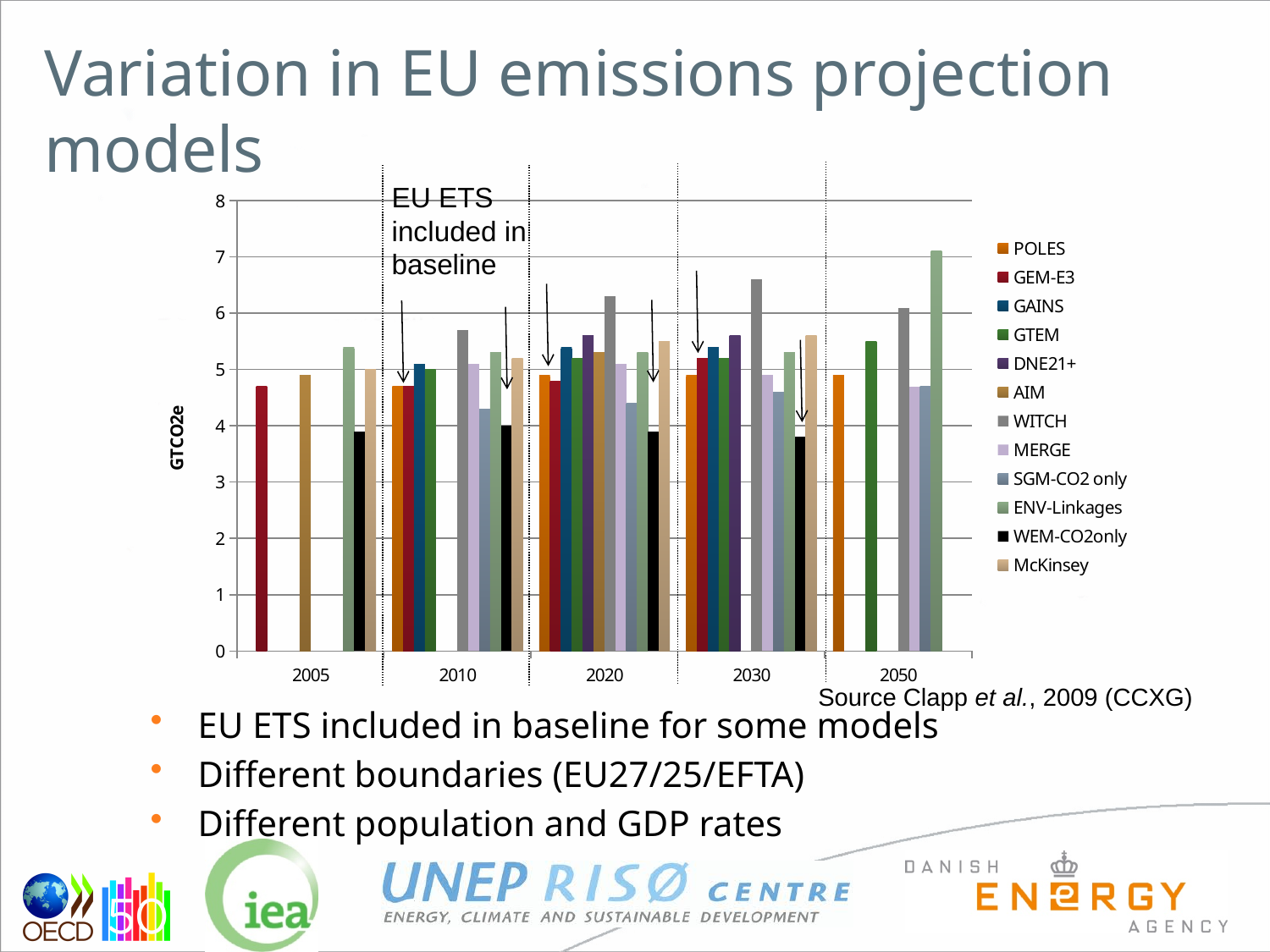
What kind of chart is shown on the slide? bar chart Which model has the highest projected value in 2030? WITCH In 2020, which is larger: the value for WITCH or the value for POLES? WITCH Is the value for GEM-E3 in 2005 greater or less than 5? less Is the value for WEM-CO2only in 2010 greater or less than 5? less What is the label on the y axis? GTCO2e How many series does the legend list? 12 Which model has the highest projected value in 2050? ENV-Linkages Is the value for ENV-Linkages in 2050 greater or less than 6? greater How many year categories are shown on the x axis? 5 Does the value for WITCH rise or fall from 2010 to 2030? rise Which model has the lowest projected value in 2030? WEM-CO2only